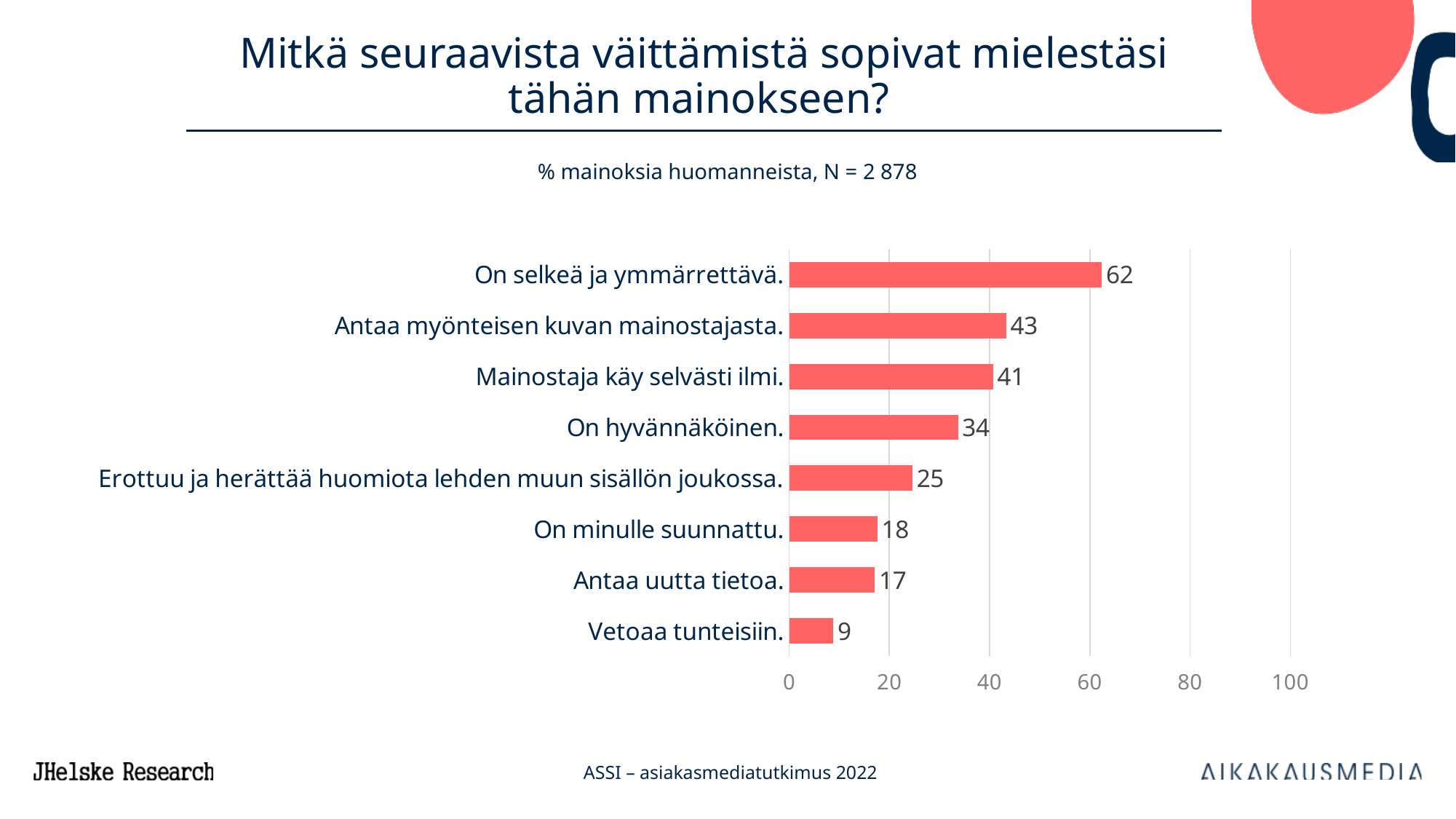
Which has a larger value, "Erottuu ja herättää huomiota lehden muun sisällön joukossa." or "On minulle suunnattu."? Erottuu ja herättää huomiota lehden muun sisällön joukossa. How many statements are shown in the chart? 8 What is the difference between the values for "On selkeä ja ymmärrettävä." and "Vetoaa tunteisiin."? 53 Which statement has the lowest value? Vetoaa tunteisiin. What is the difference between the values for "Antaa myönteisen kuvan mainostajasta." and "Mainostaja käy selvästi ilmi."? 2 What is the value for "On hyvännäköinen."? 34 Is the value for "On hyvännäköinen." greater or less than 40? less What kind of chart is shown on the slide? bar chart What is the sample size (N) stated in the chart subtitle? 2 878 What is the value for "Antaa uutta tietoa."? 17 What is the value for "On selkeä ja ymmärrettävä."? 62 Which statement has the highest value? On selkeä ja ymmärrettävä.